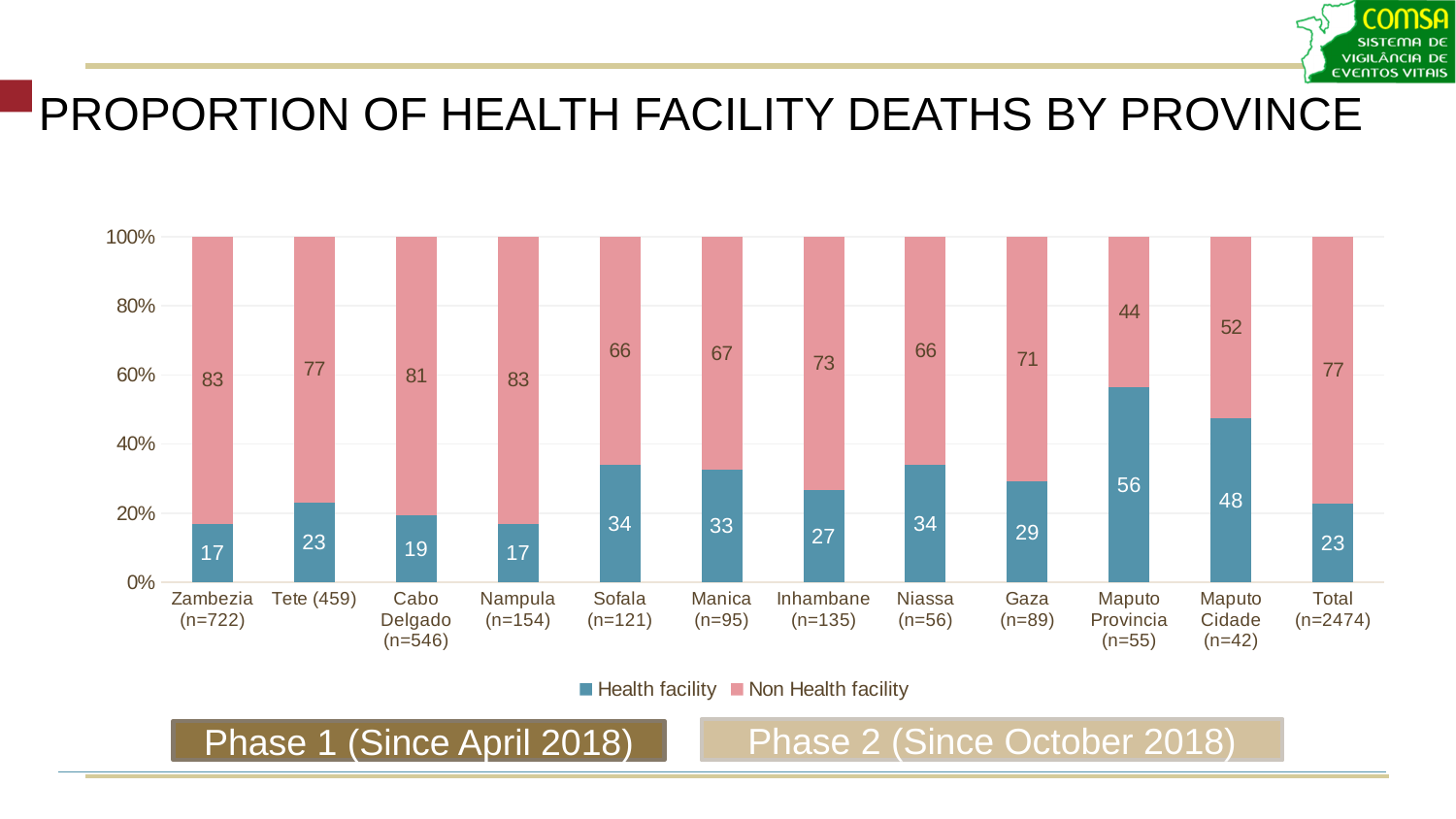
What is the Health facility value for Maputo Cidade (n=42)? 48 How many categories are shown on the x axis? 12 What kind of chart is shown on the slide? Stacked bar chart What is the Health facility value for Sofala (n=121)? 34 Which has a larger Health facility value, Inhambane (n=135) or Gaza (n=89)? Gaza (n=89) What is the Health facility value for Total (n=2474)? 23 Which province has the highest Health facility value? Maputo Provincia (n=55) What is the difference between the Non Health facility values for Zambezia (n=722) and Maputo Cidade (n=42)? 31 What is the Non Health facility value for Gaza (n=89)? 71 How many series does the legend list? 2 What is the title of the chart? PROPORTION OF HEALTH FACILITY DEATHS BY PROVINCE Which category has the lowest Non Health facility value? Maputo Provincia (n=55)